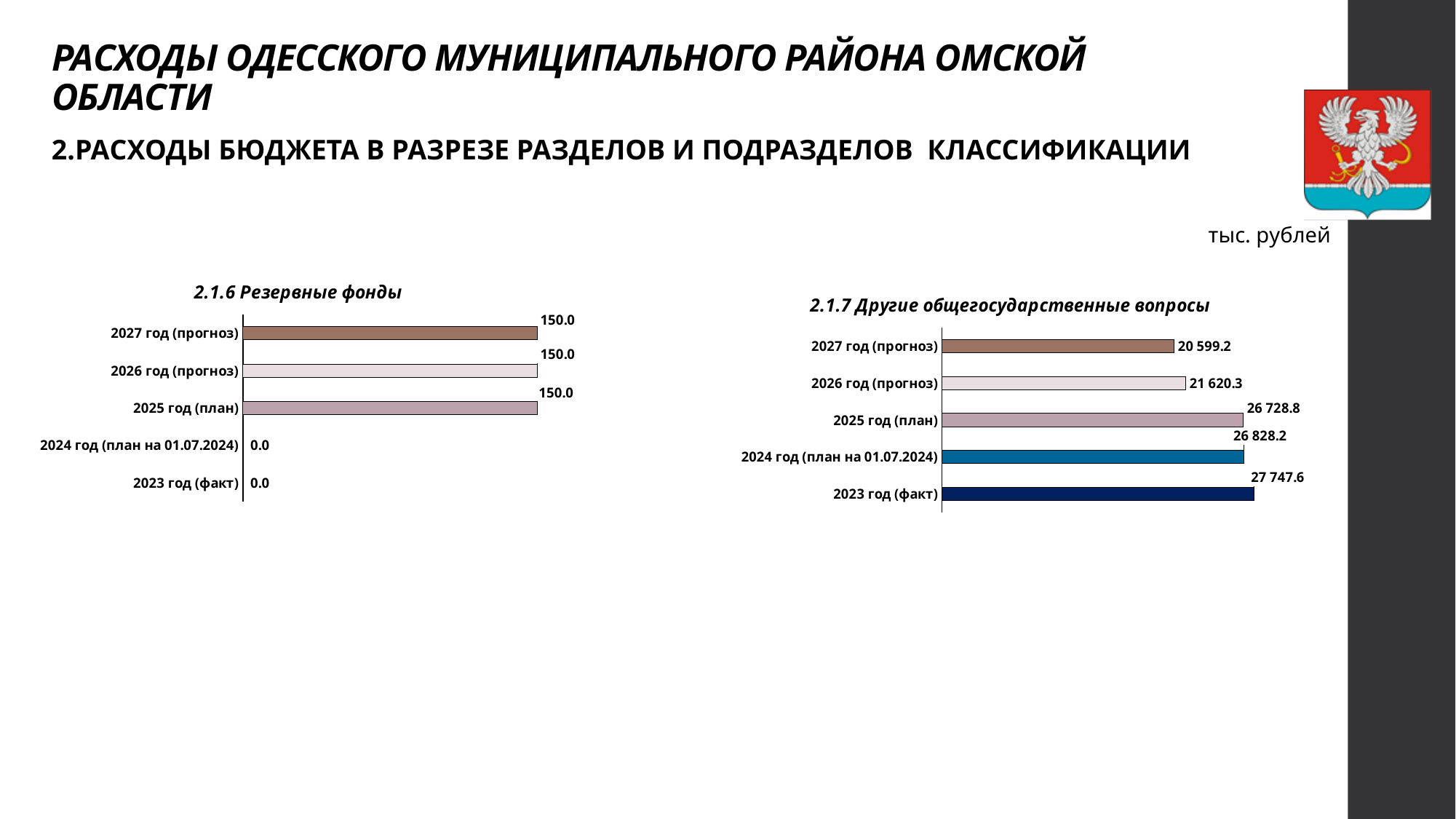
In the chart '2.1.6 Резервные фонды', what is the value for 2025 год (план)? 150.0 In the chart '2.1.6 Резервные фонды', what is the value for 2023 год (факт)? 0.0 How many categories are shown in the chart '2.1.6 Резервные фонды'? 5 What unit of measurement is stated on the slide for the charts? тыс. рублей In the chart '2.1.7 Другие общегосударственные вопросы', which category has the lowest value? 2027 год (прогноз) In the chart '2.1.7 Другие общегосударственные вопросы', what is the value for 2024 год (план на 01.07.2024)? 26 828.2 In the chart '2.1.7 Другие общегосударственные вопросы', what is the value for 2027 год (прогноз)? 20 599.2 In the chart '2.1.7 Другие общегосударственные вопросы', which category has the highest value? 2023 год (факт) In the chart '2.1.7 Другие общегосударственные вопросы', what is the difference between the values for 2023 год (факт) and 2027 год (прогноз)? 7 148.4 In the chart '2.1.7 Другие общегосударственные вопросы', which is larger: the value for 2026 год (прогноз) or 2025 год (план)? 2025 год (план) In the chart '2.1.7 Другие общегосударственные вопросы', do the values rise or fall from 2023 год (факт) to 2027 год (прогноз)? fall What kind of chart is '2.1.7 Другие общегосударственные вопросы'? bar chart